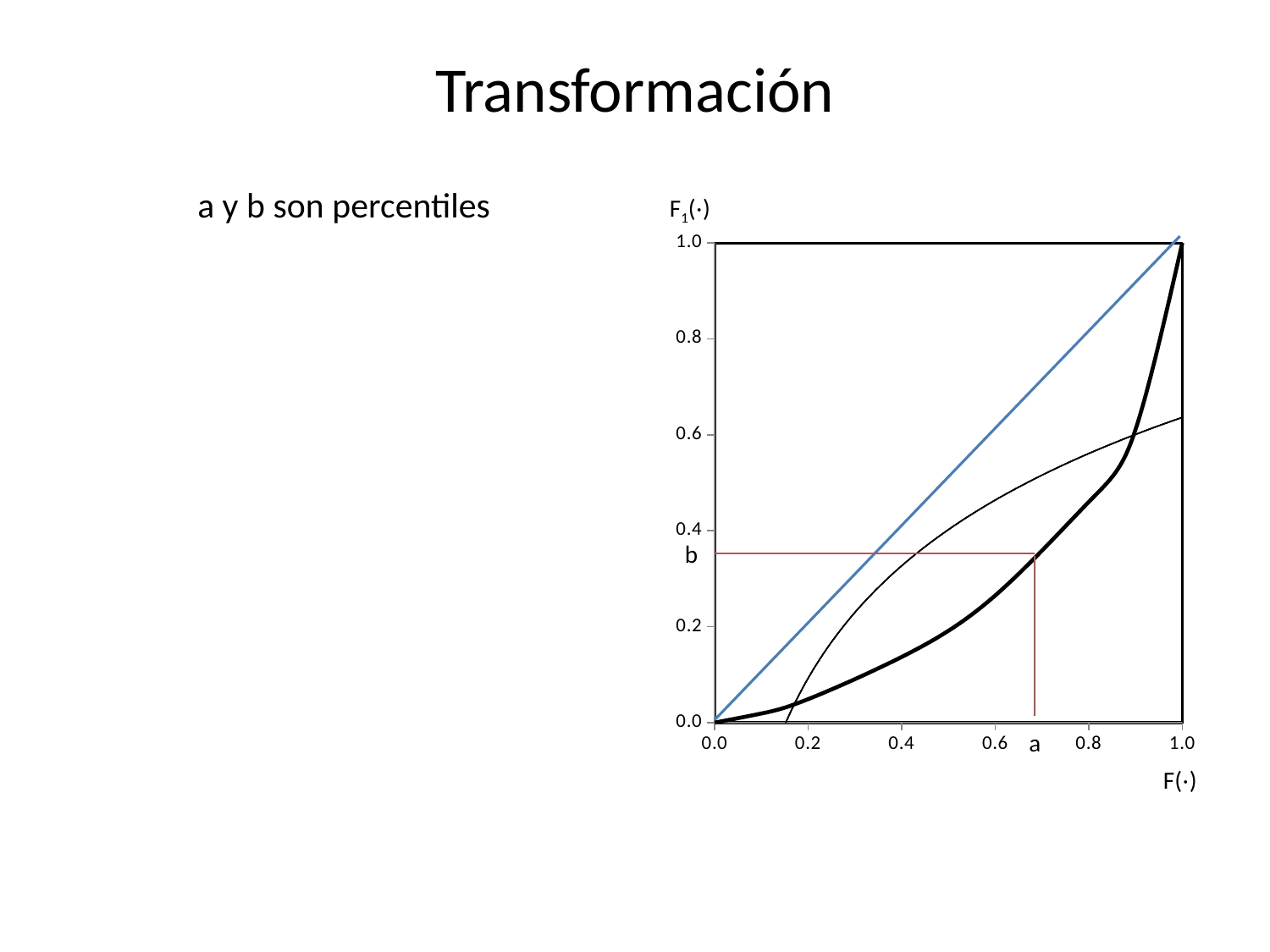
What is the value of the thick black curve at F(·) = 0.0? 0.0 What is the value of the blue straight line at F(·) = 1.0? 1.0 Is the percentile a marked on the horizontal axis greater or less than 0.6? greater What is the label of the horizontal axis of the chart? F(·) Is the percentile b marked on the vertical axis greater or less than 0.4? less What kind of chart is shown on the slide? line chart Does the thick black curve rise or fall as F(·) increases from 0.0 to 1.0? rise Is the value of the thin black curve at F(·) = 1.0 greater or less than 0.8? less What is the label of the vertical axis of the chart? F₁(·) At F(·) = 0.4, which is higher: the thin black curve or the thick black curve? the thin black curve How many curves or lines are plotted in the chart (excluding the red reference lines)? 3